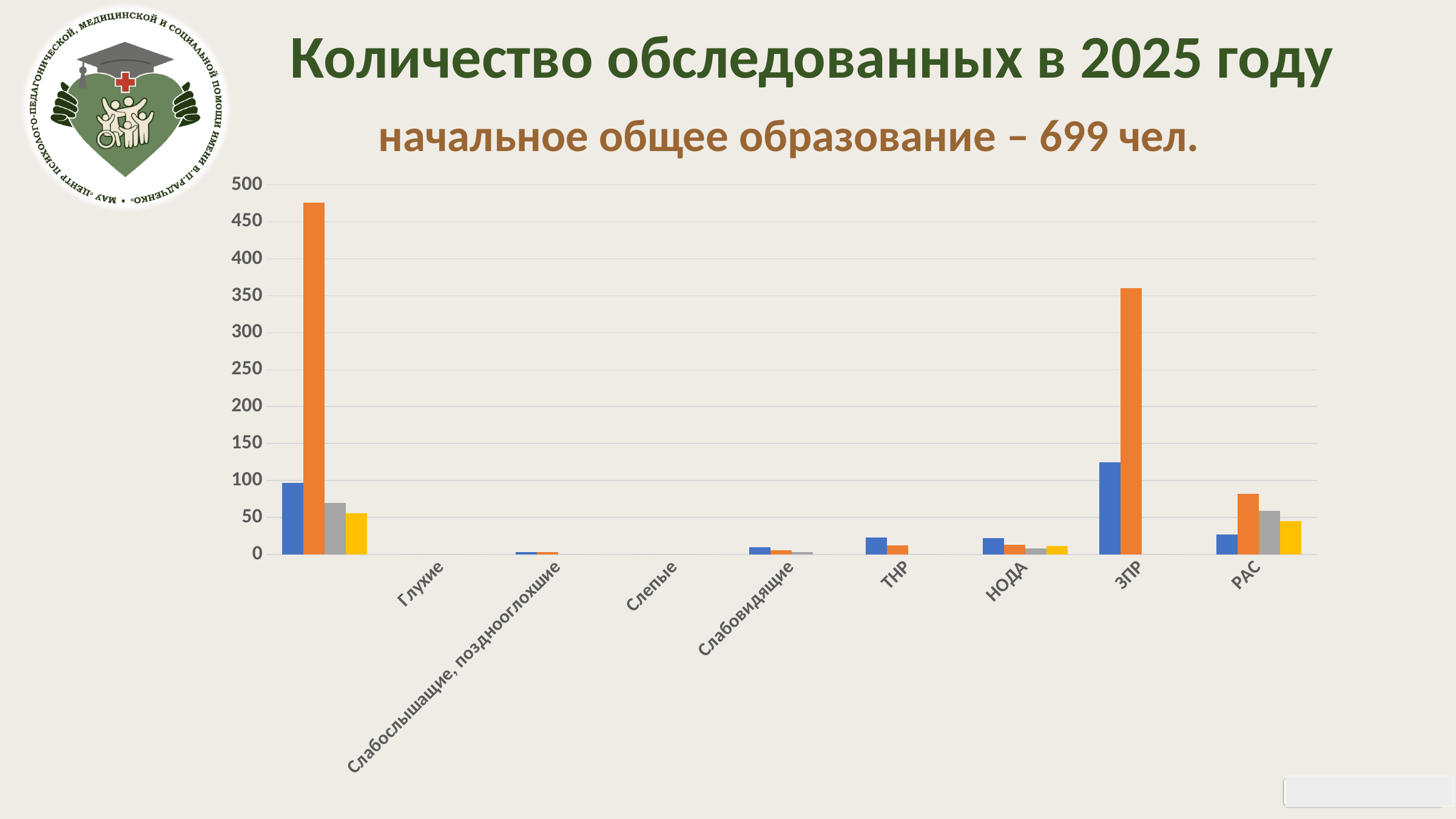
Is the orange bar for РАС greater or less than 100? less Which has the larger orange bar, ЗПР or РАС? ЗПР Is the blue bar for ЗПР greater or less than 100? greater Is the orange bar for ЗПР greater or less than 300? greater What is the highest value shown on the vertical axis? 500 Which has the larger orange bar, РАС or ТНР? РАС What kind of chart is shown on the slide? bar chart What is the title of the chart on the slide? Количество обследованных в 2025 году Among the labeled categories, which one has the tallest orange bar? ЗПР What total number of people is stated in the subtitle for начальное общее образование? 699 чел. Which has the larger blue bar, ЗПР or НОДА? ЗПР